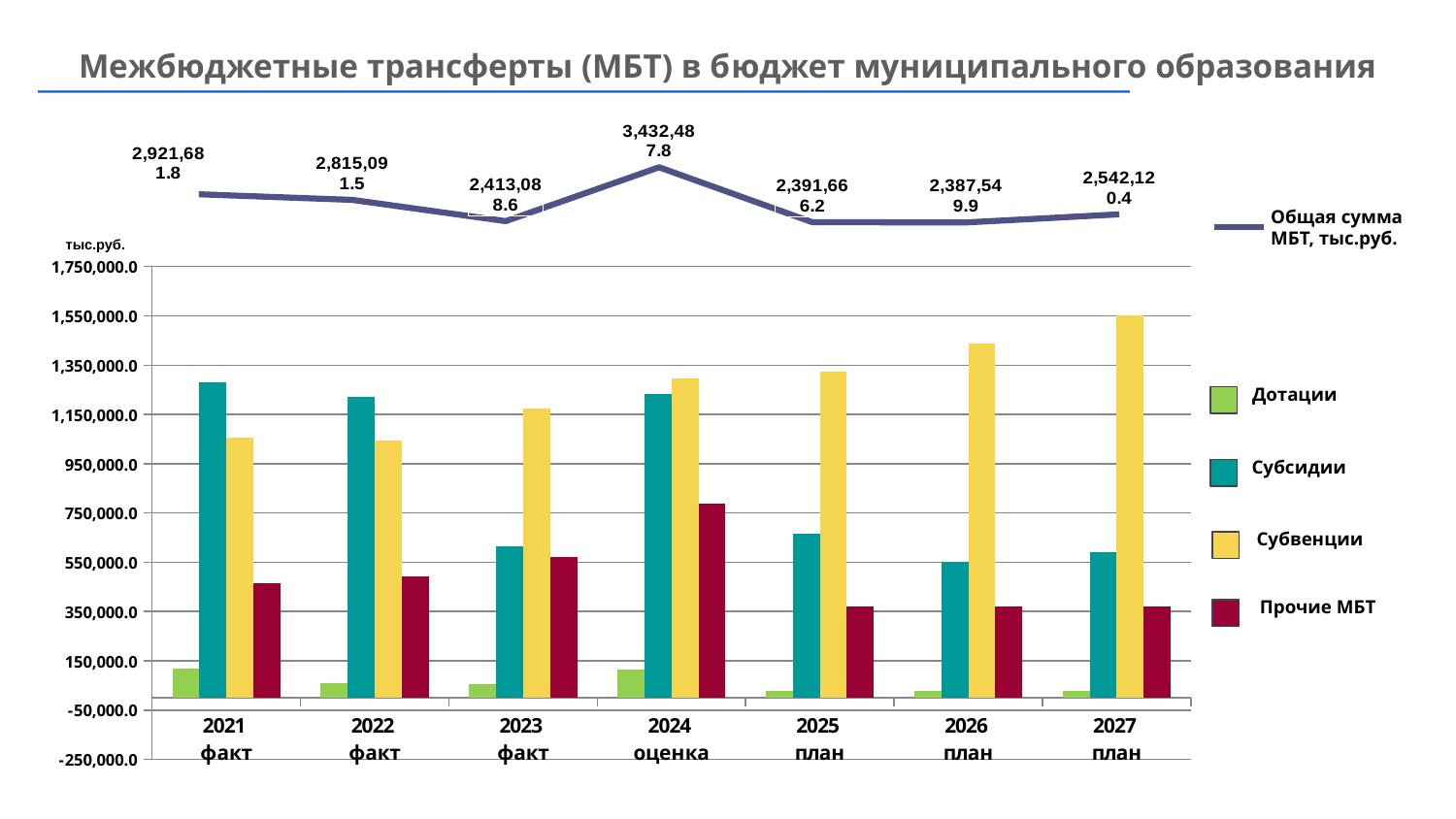
In the line chart 'Общая сумма МБТ, тыс.руб.', which year has the lowest value? 2026 план In the bar chart, is the value for Дотации in 2021 факт greater or less than 150,000.0? less In the line chart 'Общая сумма МБТ, тыс.руб.', which year has the highest value? 2024 оценка In the line chart 'Общая сумма МБТ, тыс.руб.', what is the value for 2024 оценка? 3,432,487.8 In the bar chart, is the value for Субвенции in 2026 план greater or less than 1,350,000.0? greater In the bar chart, do the values for Субвенции rise or fall from 2024 оценка to 2027 план? rise In the bar chart, which is larger in 2027 план: Субвенции or Субсидии? Субвенции In the line chart 'Общая сумма МБТ, тыс.руб.', which is larger: the value for 2022 факт or 2027 план? 2022 факт In the bar chart, how many series does the legend list? 4 In the line chart 'Общая сумма МБТ, тыс.руб.', what is the value for 2021 факт? 2,921,681.8 In the bar chart, is the value for Субсидии in 2025 план greater or less than 750,000.0? less In the line chart 'Общая сумма МБТ, тыс.руб.', what is the difference between the 2024 оценка value and the 2021 факт value? 510,806.0